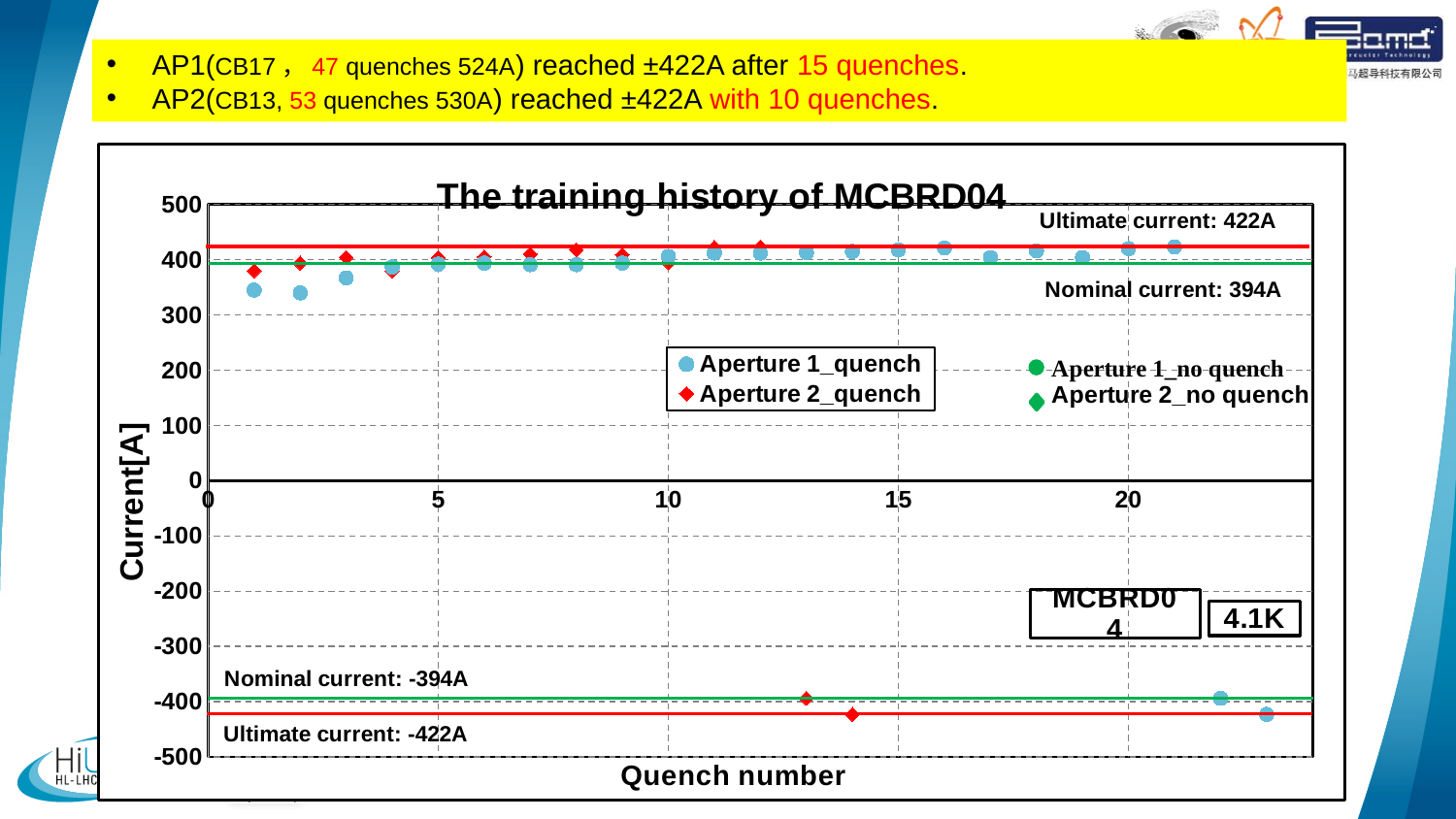
What is the label of the y axis of the chart? Current[A] Is the Aperture 1_quench value at quench number 1 greater or less than 400? less What type of chart is shown on the slide? scatter chart What ultimate current value is marked by the upper red reference line on the chart? 422A Do the Aperture 1_quench values generally rise or fall as the quench number increases from 1 to 20? rise What nominal current value is marked by the upper green reference line on the chart? 394A Is the Aperture 1_quench value at quench number 20 greater or less than 400? greater How many series does the chart legend list? 2 What is the value of the lower ultimate current reference line on the chart? -422A What is the title of the chart? The training history of MCBRD04 What is the difference between the ultimate current and the nominal current shown on the chart? 28A What is the value of the lower nominal current reference line on the chart? -394A